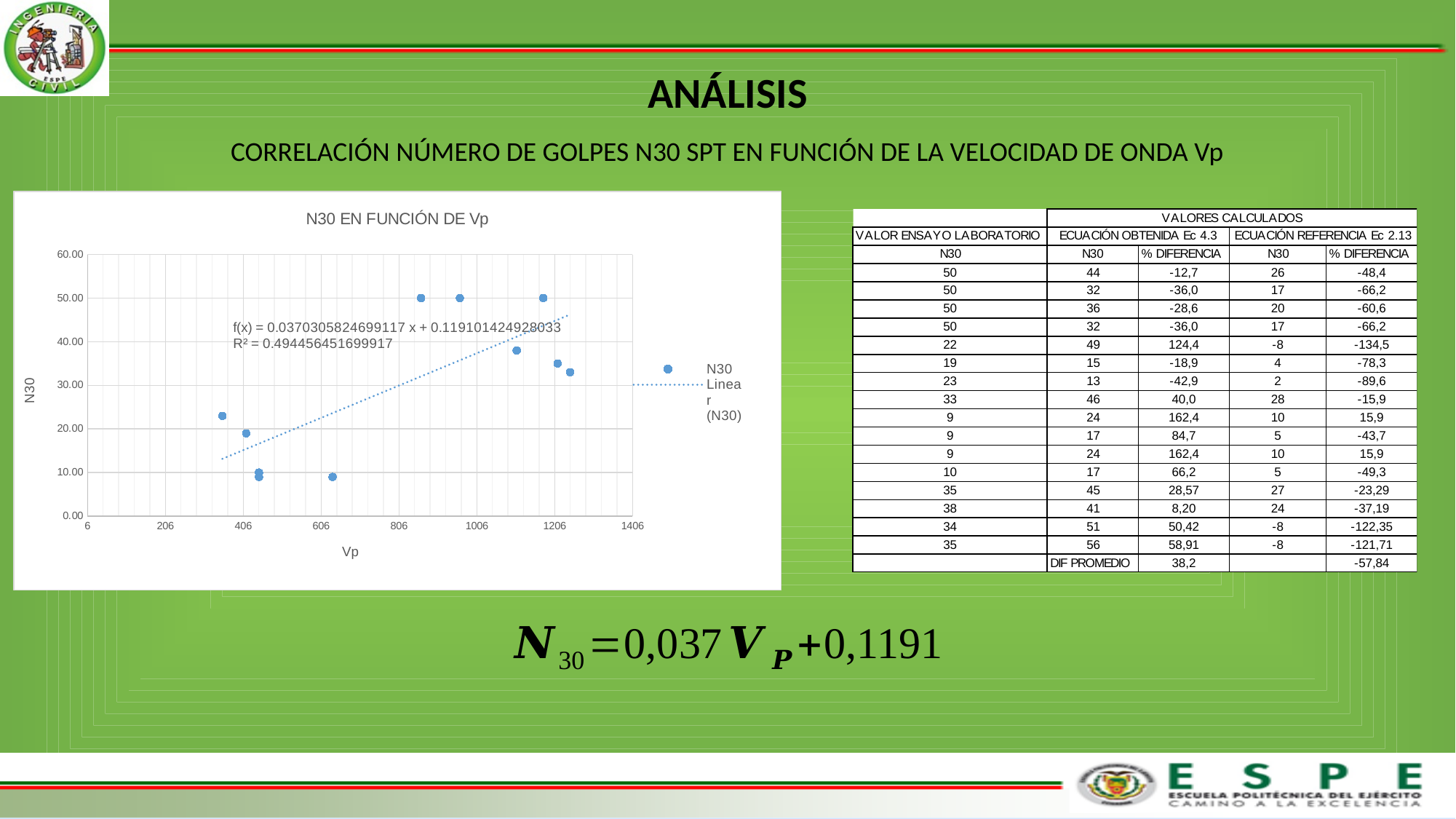
Is the N30 value of the rightmost plotted point (near Vp = 1250) greater or less than 40? less What is the highest value shown on the y axis of the chart? 60.00 Is the N30 value of the leftmost plotted point (near Vp = 350) greater or less than 20? greater What kind of chart is shown on the slide? scatter chart Is the N30 value of the highest plotted points in the chart greater or less than 40? greater Does the dotted trendline in the chart rise or fall as Vp increases? rises What is the equation of the trendline printed on the chart? f(x) = 0.0370305824699117 x + 0.119101424928033 What R² value is printed on the chart? R² = 0.494456451699917 What label is on the x axis of the chart? Vp How many entries does the chart legend list? 2 What is the title of the chart on the slide? N30 EN FUNCIÓN DE Vp